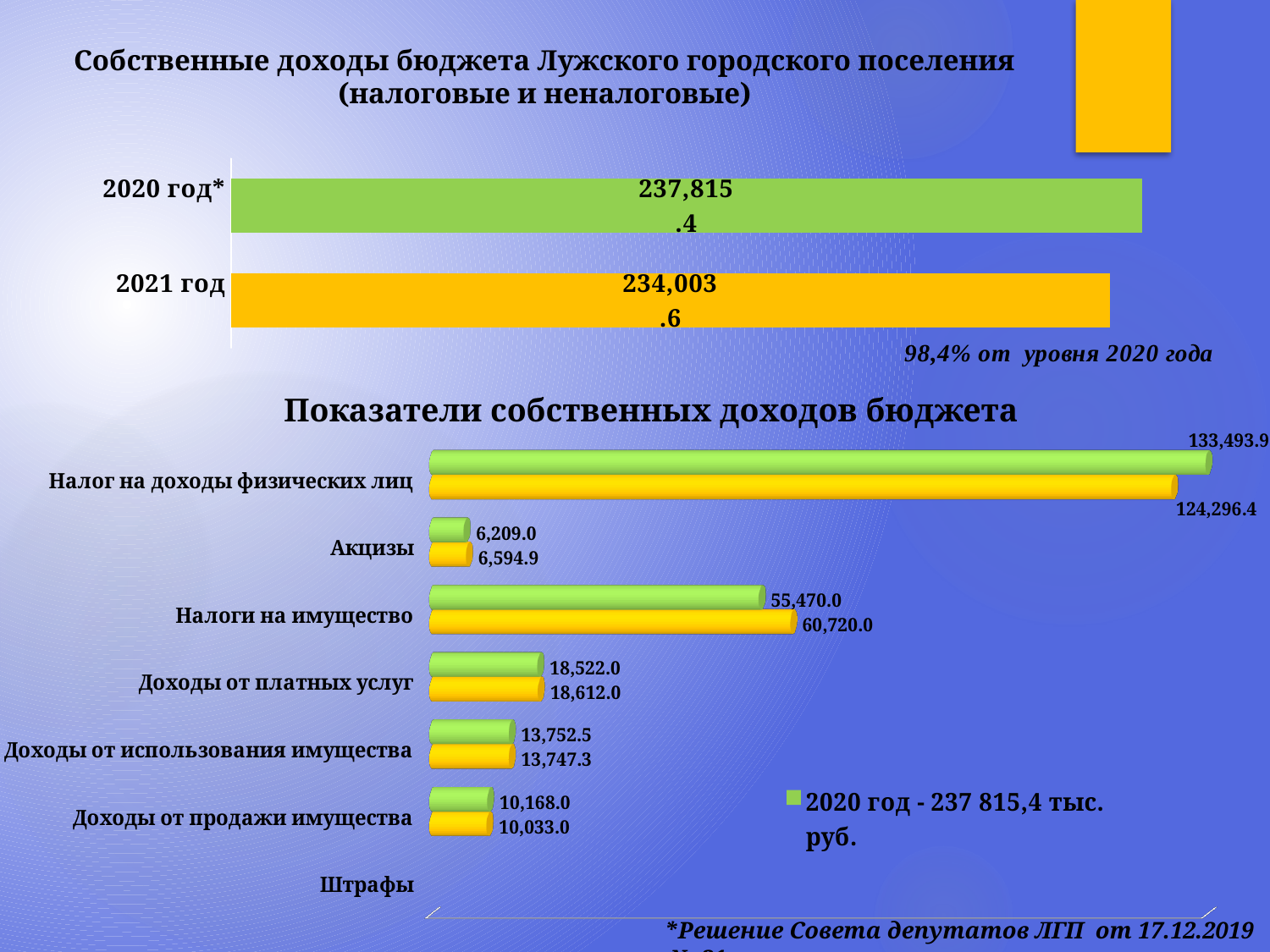
In the chart 'Показатели собственных доходов бюджета', what is the value of the green (2020 год) bar for Налог на доходы физических лиц? 133,493.9 In the chart 'Показатели собственных доходов бюджета', which category with labelled bars has the lowest green (2020 год) value? Акцизы In the top chart, which year has the larger value, 2020 год* or 2021 год? 2020 год* In the chart 'Показатели собственных доходов бюджета', which is larger for Акцизы, the green bar (6,209.0) or the yellow bar (6,594.9)? The yellow bar (6,594.9) In the top chart, what is the value for 2021 год? 234,003.6 In the chart 'Показатели собственных доходов бюджета', what is the difference between the green and yellow bars for Налог на доходы физических лиц? 9,197.5 In the chart 'Показатели собственных доходов бюджета', which category has the highest green (2020 год) value? Налог на доходы физических лиц How many category labels are listed on the vertical axis of the chart 'Показатели собственных доходов бюджета'? 7 What kind of chart is the top chart? Bar chart In the chart 'Показатели собственных доходов бюджета', what is the value of the yellow bar for Налоги на имущество? 60,720.0 In the top chart, what is the difference between the 2020 год* and 2021 год values? 3,811.8 In the top chart, what is the value for 2020 год*? 237,815.4